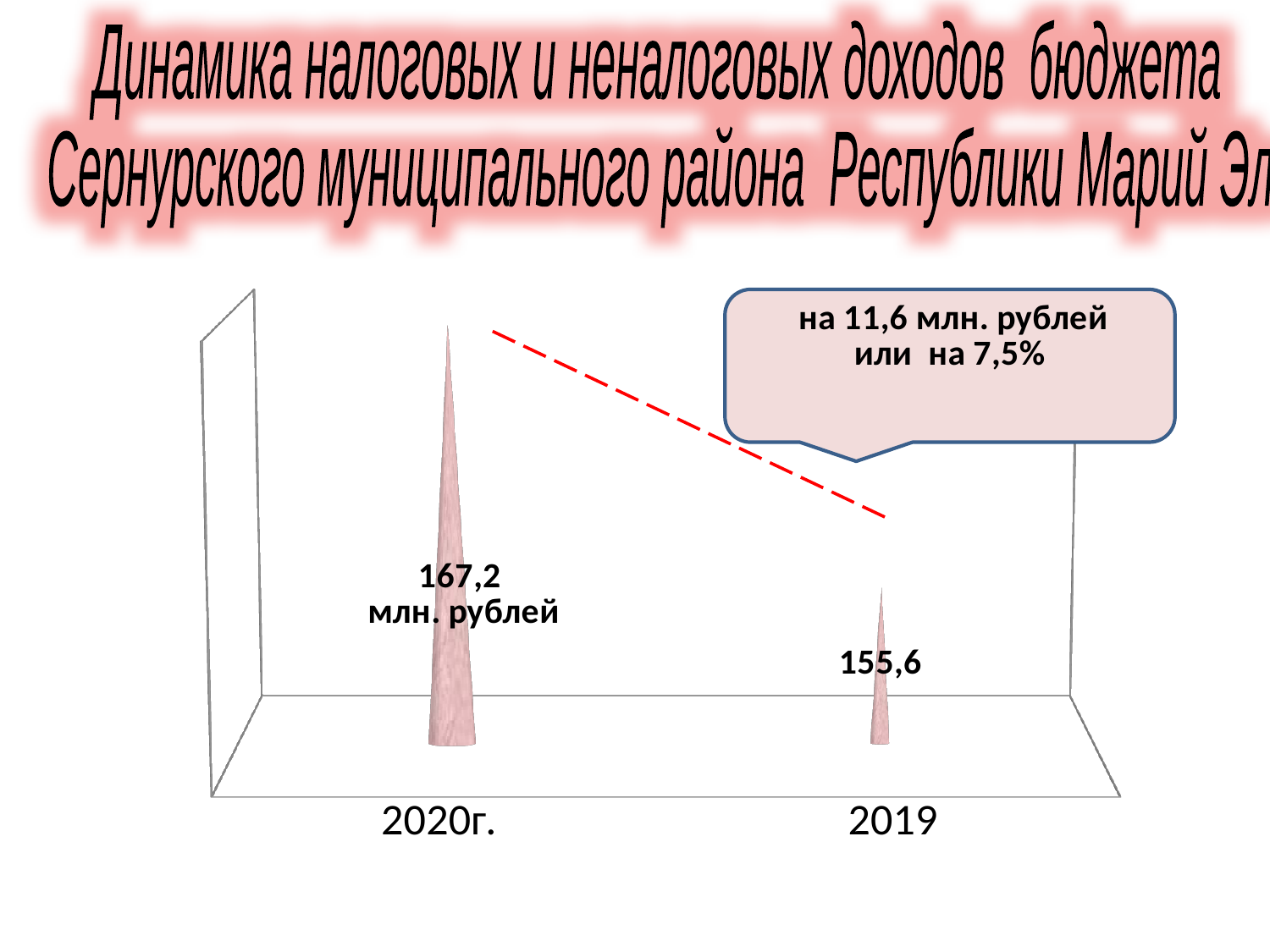
By what percentage does the callout say the value changed? 7,5% What is the first line of the slide title? Динамика налоговых и неналоговых доходов бюджета What kind of chart is shown on the slide? bar chart Which year has the lowest value? 2019 What is the difference between the values for 2020г. and 2019? 11,6 How many categories are shown on the x axis? 2 Which year has the highest value? 2020г. Do the values rise or fall from left to right along the x axis? fall What is the value for 2020г.? 167,2 млн. рублей What is the value for 2019? 155,6 Which is larger, the value for 2020г. or the value for 2019? 2020г.